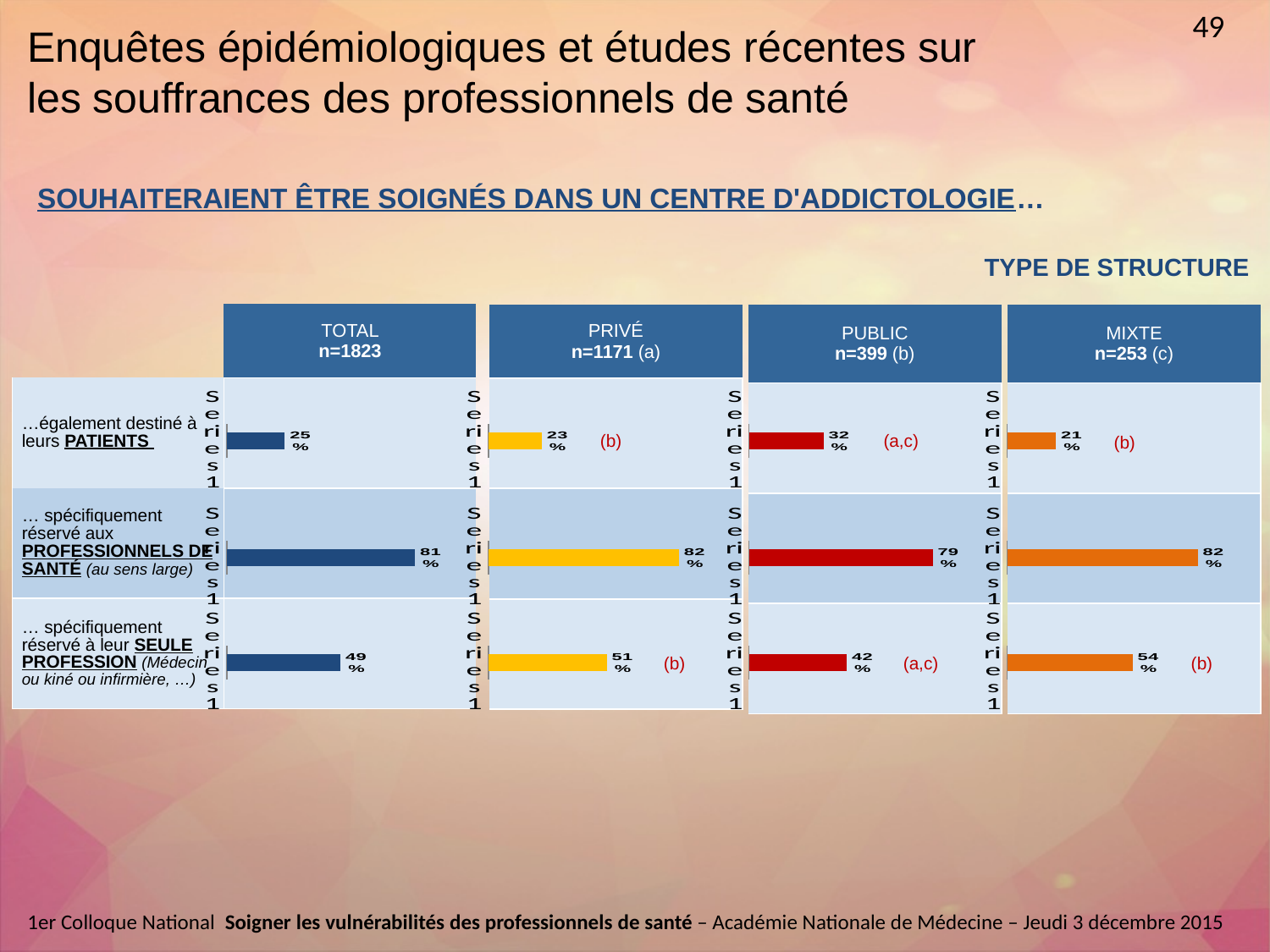
In the row '…également destiné à leurs PATIENTS', what is the difference between the PUBLIC value and the MIXTE value? 11% What kind of chart is used in each cell of the grid? Bar chart Across the row '… spécifiquement réservé à leur SEULE PROFESSION', which structure type (TOTAL, PRIVÉ, PUBLIC or MIXTE) has the lowest value? PUBLIC In the PRIVÉ column, what is the value shown for the bar in the row '…également destiné à leurs PATIENTS'? 23% What is the sample size (n) shown for the PUBLIC column? n=399 In the PRIVÉ column, which is larger: the value for '… spécifiquement réservé aux PROFESSIONNELS DE SANTÉ' or the value for '… spécifiquement réservé à leur SEULE PROFESSION'? … spécifiquement réservé aux PROFESSIONNELS DE SANTÉ In the MIXTE column, what is the value shown for the bar in the row '… spécifiquement réservé à leur SEULE PROFESSION'? 54% How many structure-type columns of charts are shown (TOTAL, PRIVÉ, PUBLIC, MIXTE)? 4 In the PUBLIC column, what is the value shown for the bar in the row '… spécifiquement réservé aux PROFESSIONNELS DE SANTÉ'? 79% Across the row '…également destiné à leurs PATIENTS', which structure type (TOTAL, PRIVÉ, PUBLIC or MIXTE) has the highest value? PUBLIC In the TOTAL column, what is the value shown for the bar in the row '…également destiné à leurs PATIENTS'? 25% In the row '… spécifiquement réservé à leur SEULE PROFESSION', what is the difference between the MIXTE value and the PUBLIC value? 12%